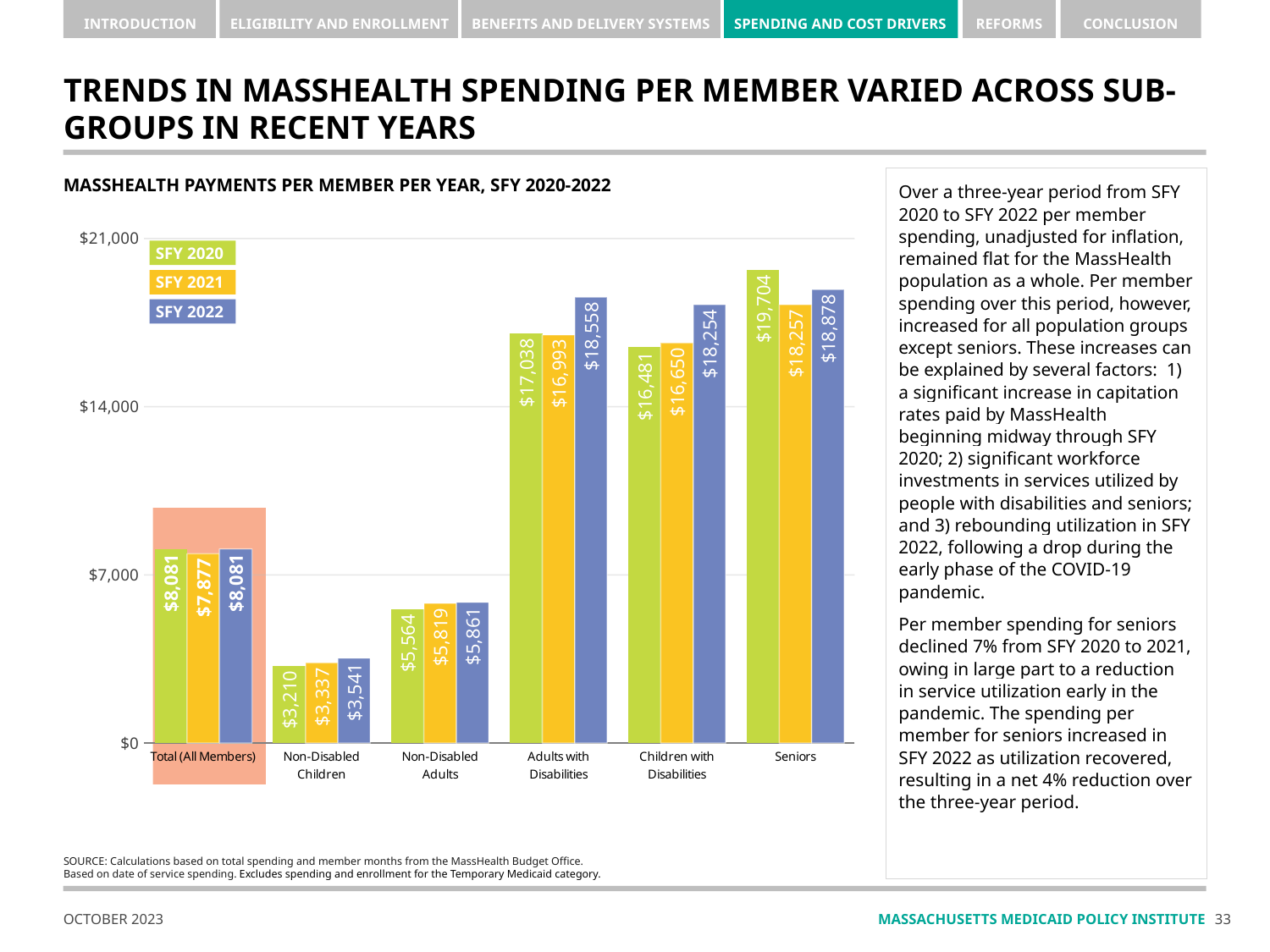
Which colour represents SFY 2021 in the chart? Yellow What was the payment per member for Adults with Disabilities in SFY 2021? $16,993 How many member categories are shown on the x axis? 6 Which category had the highest payment per member in SFY 2020? Seniors Which was larger in SFY 2022: the payment per member for Adults with Disabilities or for Seniors? Seniors Which category had the lowest payment per member in SFY 2022? Non-Disabled Children How many series does the legend list? 3 What was the payment per member for Non-Disabled Children in SFY 2022? $3,541 What was the MassHealth payment per member per year for Seniors in SFY 2020? $19,704 Did the payment per member for Non-Disabled Adults rise or fall from SFY 2020 to SFY 2022? Rise What kind of chart is shown on the slide? Bar chart What is the difference between the SFY 2022 and SFY 2020 payments per member for Children with Disabilities? $1,773